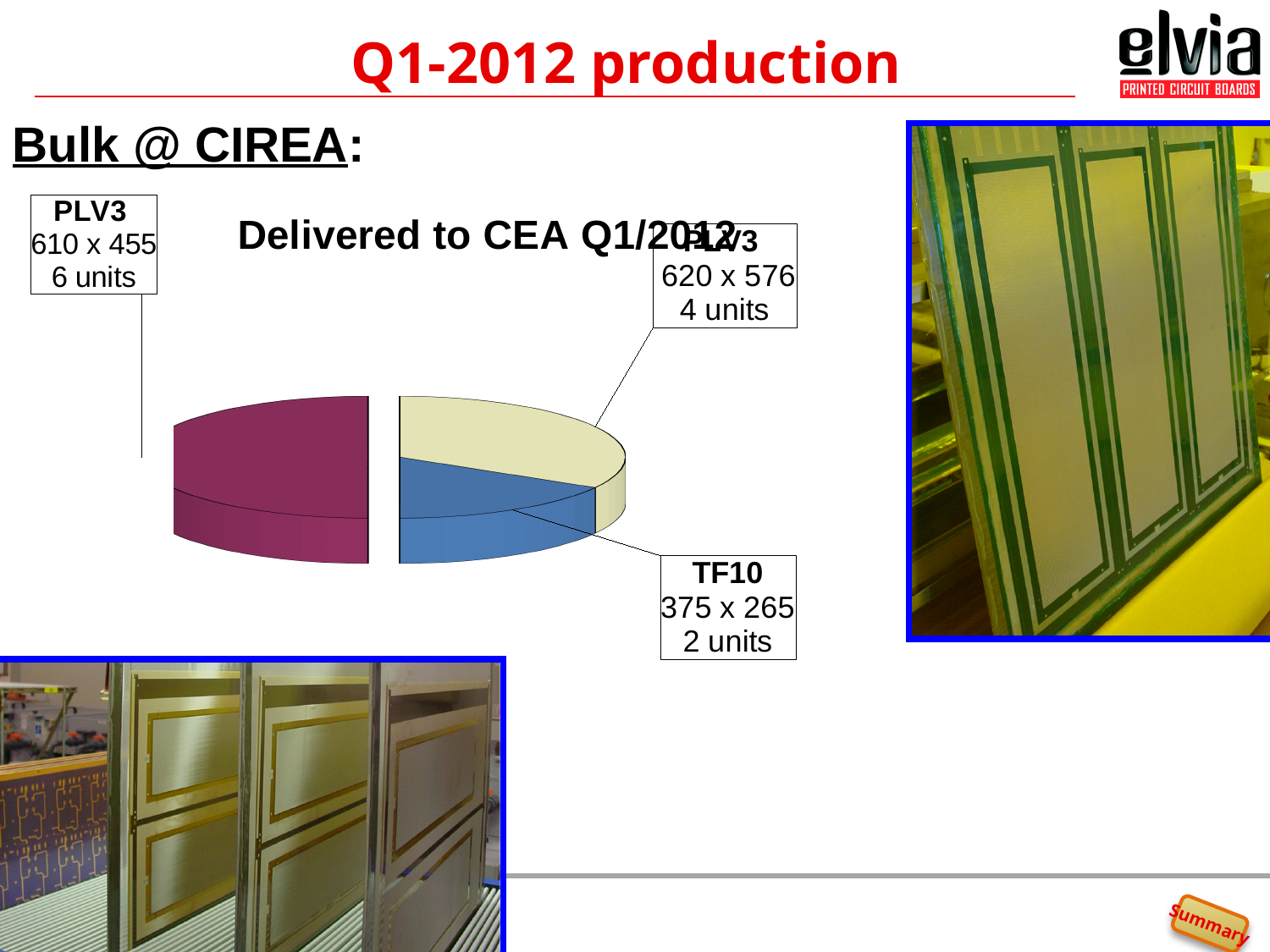
What dimensions are given for TF10 in the pie chart label? 375 x 265 What kind of chart is shown on the slide? pie chart How many units of TF10 were delivered according to the pie chart? 2 units How many units are shown for the 620 x 576 board in the pie chart? 4 units Which board type has the largest slice in the pie chart? PLV3 What is the title of the pie chart? Delivered to CEA Q1/2012 What is the total number of units across all slices of the pie chart? 12 units Which board type has the smallest slice in the pie chart? TF10 How many slices does the pie chart have? 3